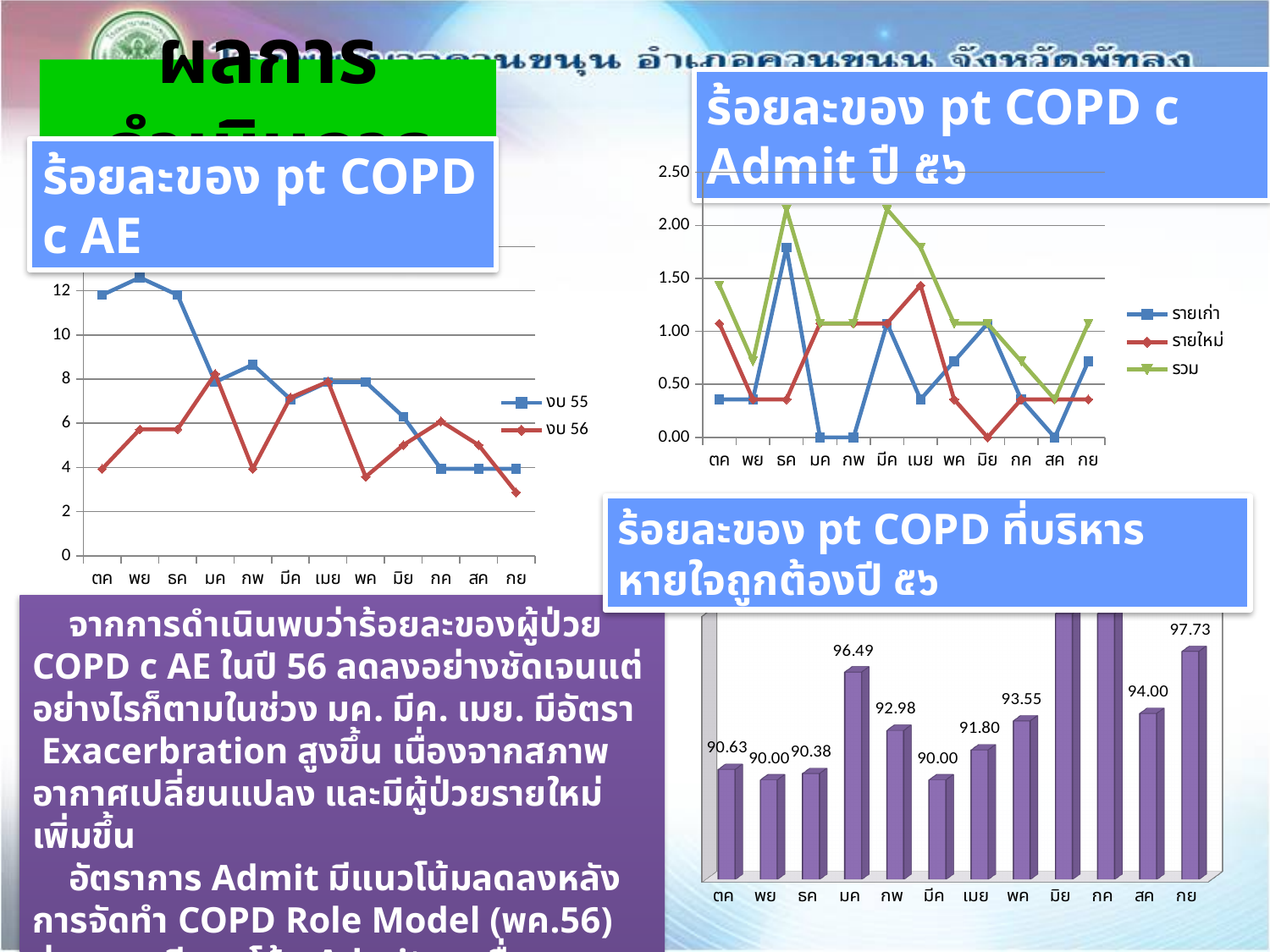
In the bar chart 'ร้อยละของ pt COPD ที่บริหารหายใจถูกต้องปี ๕๖', what is the value for มค? 96.49 How many series does the legend of the chart 'ร้อยละของ pt COPD c AE' list? 2 In the bar chart 'ร้อยละของ pt COPD ที่บริหารหายใจถูกต้องปี ๕๖', what is the value for สค? 94.00 In the chart 'ร้อยละของ pt COPD c AE', is the value for งบ 56 at กย greater or less than 4? less In the bar chart 'ร้อยละของ pt COPD ที่บริหารหายใจถูกต้องปี ๕๖', which is larger, the value for กพ or the value for พค? พค In the bar chart 'ร้อยละของ pt COPD ที่บริหารหายใจถูกต้องปี ๕๖', what is the value for กย? 97.73 In the bar chart 'ร้อยละของ pt COPD ที่บริหารหายใจถูกต้องปี ๕๖', what is the difference between the values for มค and ตค? 5.86 What kind of chart is 'ร้อยละของ pt COPD ที่บริหารหายใจถูกต้องปี ๕๖'? bar chart How many months are shown on the x axis of the bar chart 'ร้อยละของ pt COPD ที่บริหารหายใจถูกต้องปี ๕๖'? 12 How many series does the legend of the chart 'ร้อยละของ pt COPD c Admit ปี ๕๖' list? 3 In the chart 'ร้อยละของ pt COPD c AE', is the value for งบ 55 at ตค greater or less than 10? greater In the chart 'ร้อยละของ pt COPD c Admit ปี ๕๖', what is the value for รายเก่า at มค? 0.00